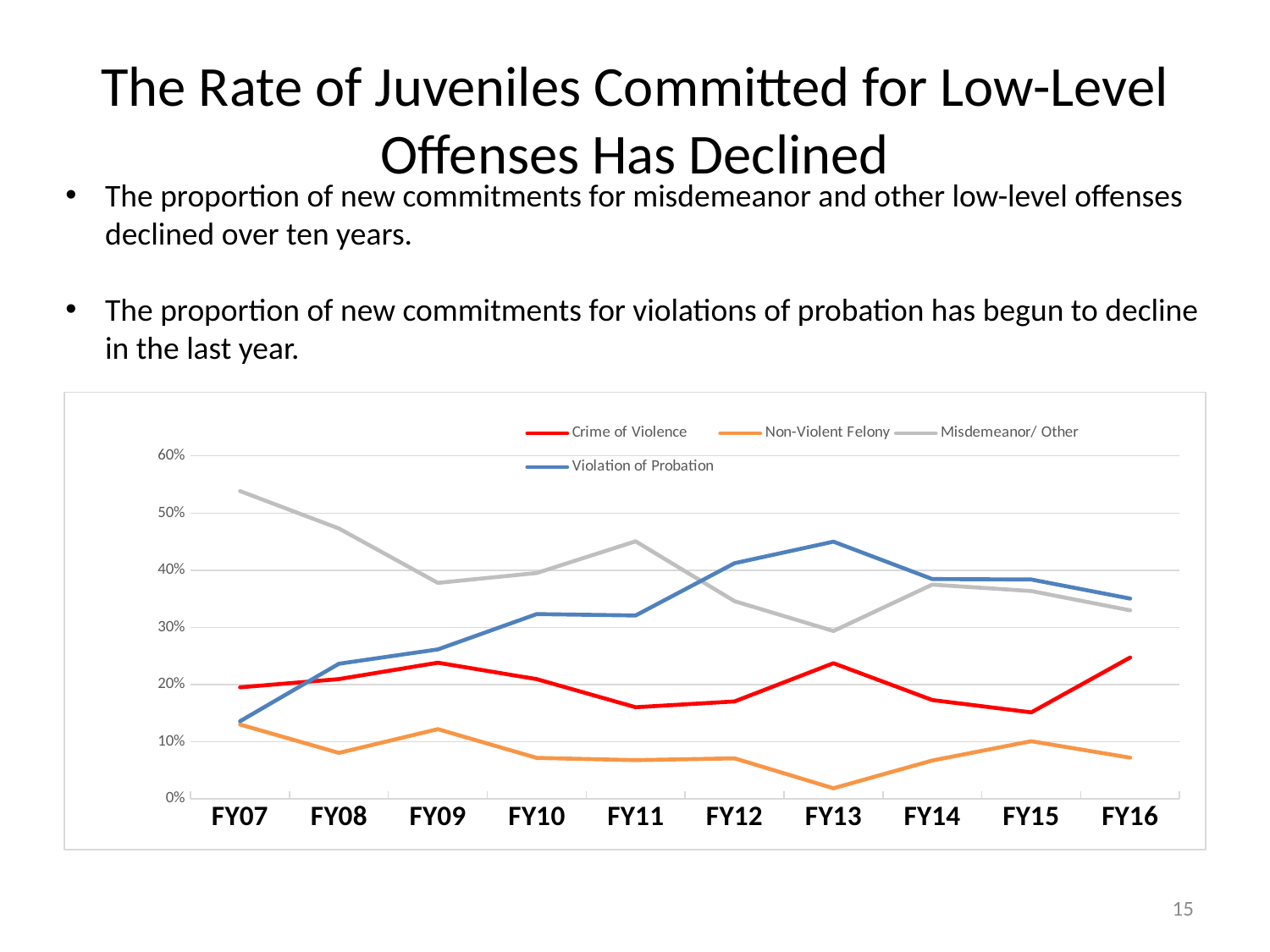
How many fiscal years are plotted along the x axis? 10 In which fiscal year is the Non-Violent Felony series at its lowest? FY13 What kind of chart is shown on the slide? line chart How many series does the chart legend list? 4 Does the Violation of Probation series rise or fall from FY07 to FY13? rise Is the Violation of Probation value for FY13 greater or less than 40%? greater Is the Crime of Violence value for FY16 greater or less than 20%? greater In FY13, which is larger: Violation of Probation or Misdemeanor/ Other? Violation of Probation Is the Non-Violent Felony value for FY13 greater or less than 10%? less Which colour is used for the Crime of Violence line? red In which fiscal year is the Misdemeanor/ Other series at its highest? FY07